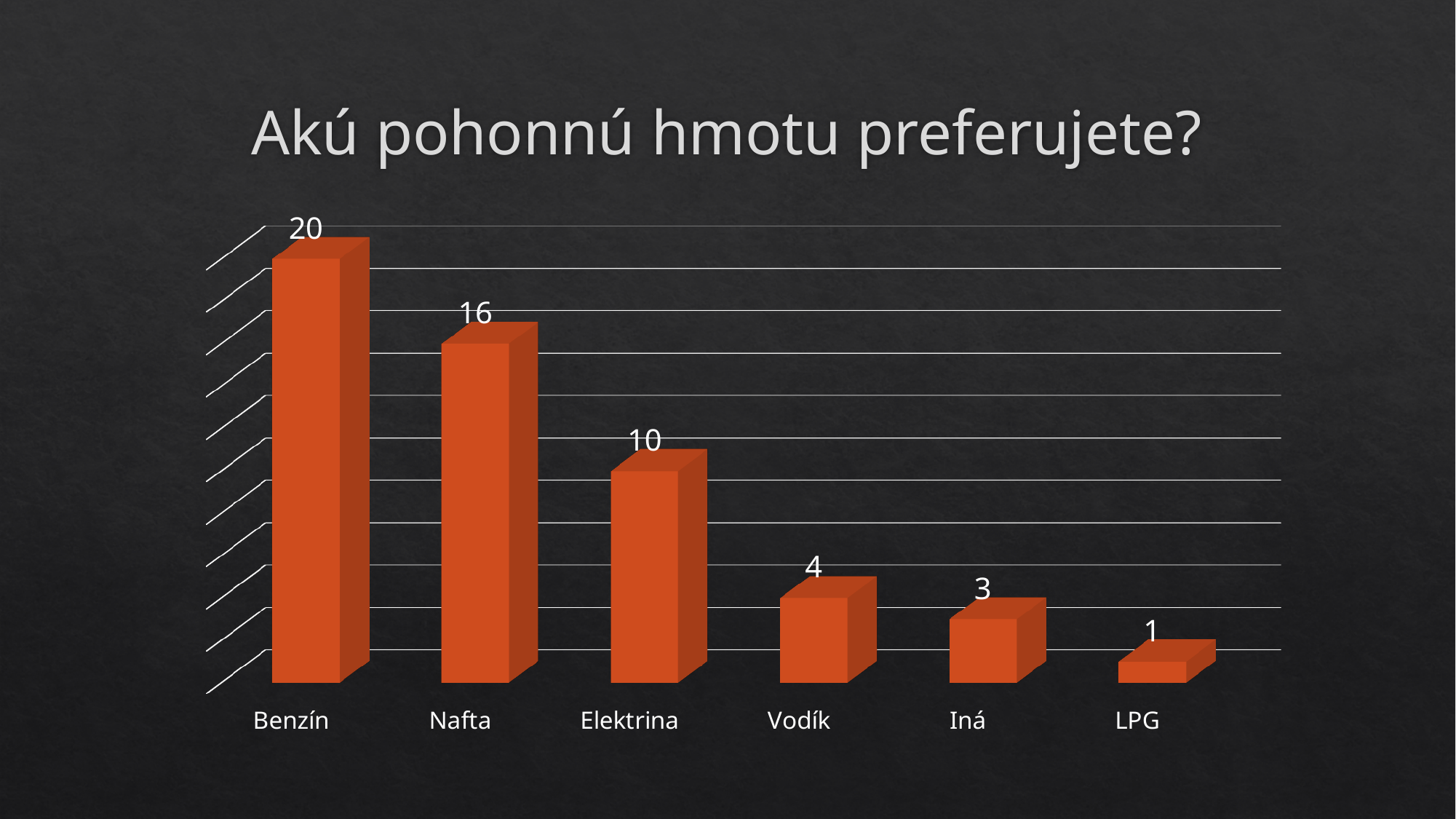
What is the value for LPG? 1 What is the value for Benzín? 20 Which category has the highest value? Benzín How many categories are shown on the x axis? 6 What is the difference between the values for Benzín and Nafta? 4 What kind of chart is shown on the slide? Bar chart Which category has the lowest value? LPG What is the value for Elektrina? 10 Which is larger, the value for Vodík or the value for Iná? Vodík What is the difference between the values for Elektrina and Vodík? 6 What is the title of the chart? Akú pohonnú hmotu preferujete? What is the value for Nafta? 16